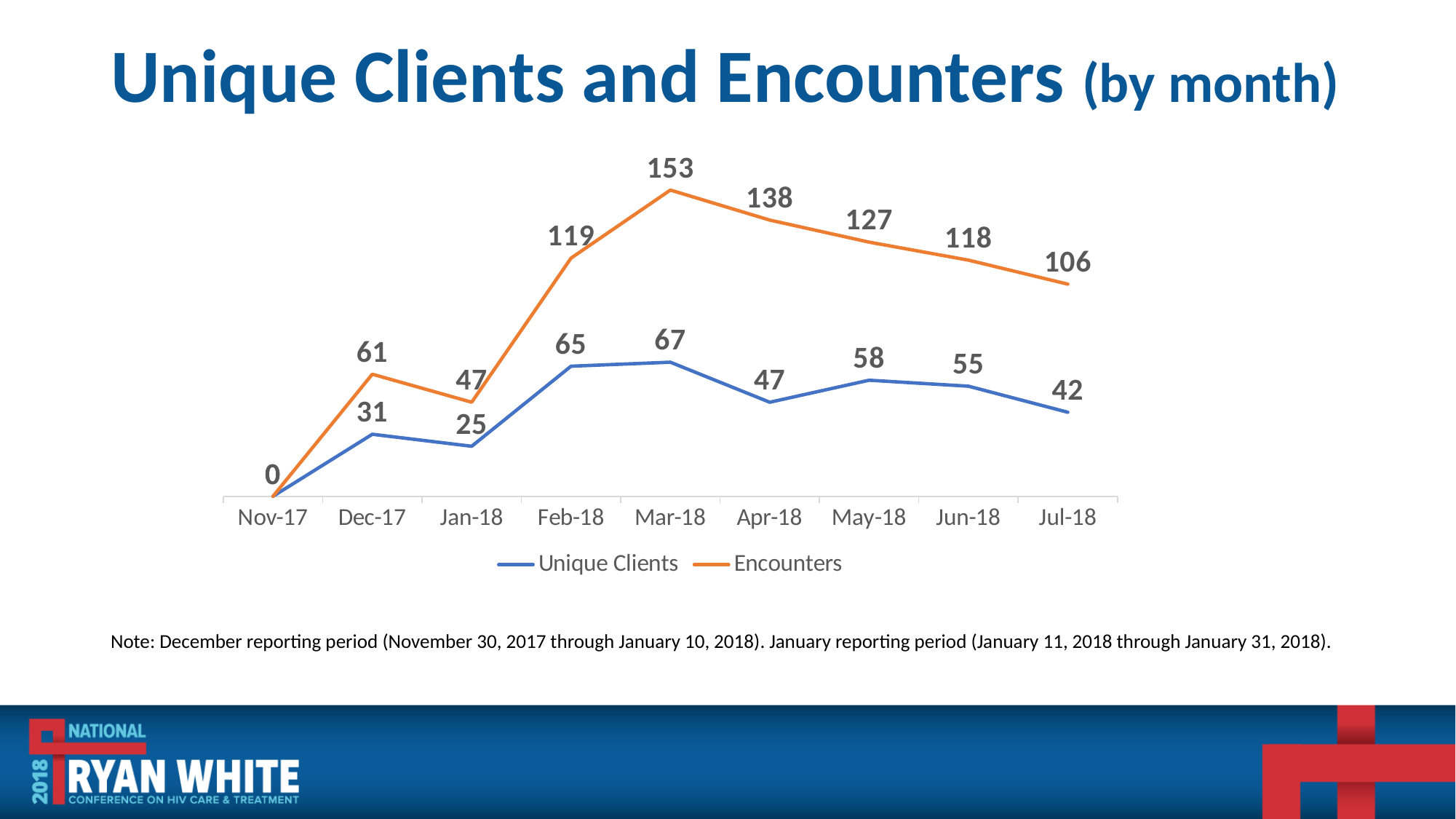
How many series does the legend list? 2 What is the number of Unique Clients in Feb-18? 65 What is the difference between Encounters and Unique Clients in Apr-18? 91 Do Encounters rise or fall from Mar-18 to Jul-18? Fall What is the number of Encounters in Mar-18? 153 Which is larger: Unique Clients in May-18 or Unique Clients in Jun-18? May-18 What is the number of Encounters in Jul-18? 106 In which month is the number of Unique Clients highest? Mar-18 How many months are plotted along the x axis? 9 Excluding Nov-17, in which month is the number of Encounters lowest? Jan-18 What type of chart is shown on the slide? Line chart What colour is the Encounters line? Orange